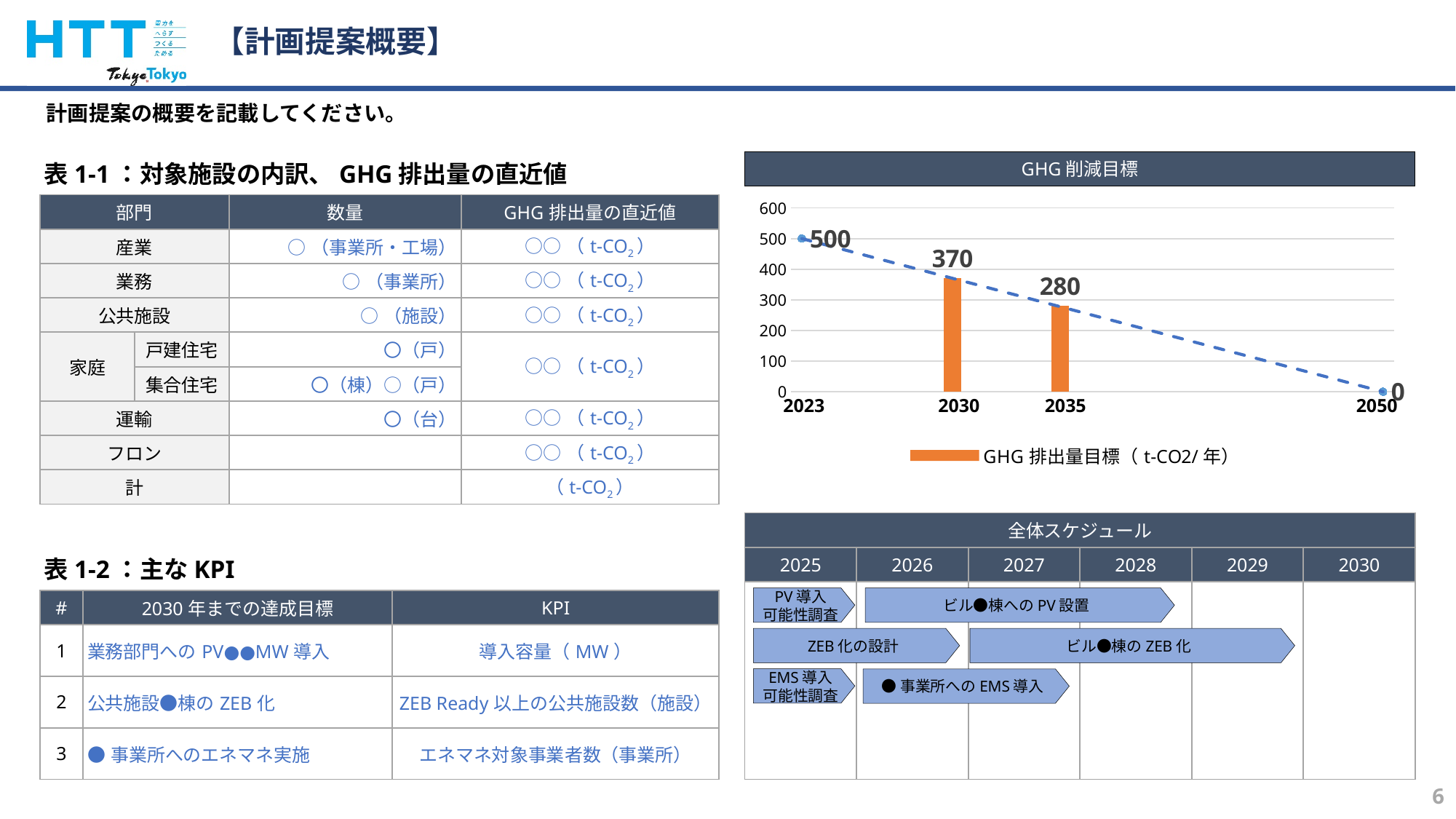
In the GHG 削減目標 chart, what is the value labelled for 2023? 500 In the GHG 削減目標 chart, what is the value labelled for 2050? 0 In the GHG 削減目標 chart, which is larger, the value for 2030 or the value for 2035? 2030 In the GHG 削減目標 chart, which year has the highest labelled value? 2023 In the GHG 削減目標 chart, what is the difference between the 2023 value and the 2030 value? 130 In the GHG 削減目標 chart, how many years are shown on the x axis? 4 In the GHG 削減目標 chart, which year has the lowest labelled value? 2050 In the GHG 削減目標 chart, what is the difference between the 2030 value and the 2035 value? 90 In the GHG 削減目標 chart, what is the value labelled for 2035? 280 In the GHG 削減目標 chart, do the values rise or fall from 2023 to 2050? fall In the GHG 削減目標 chart, what is the legend entry shown below the chart? GHG 排出量目標（t-CO2/年） In the GHG 削減目標 chart, what is the value labelled for 2030? 370